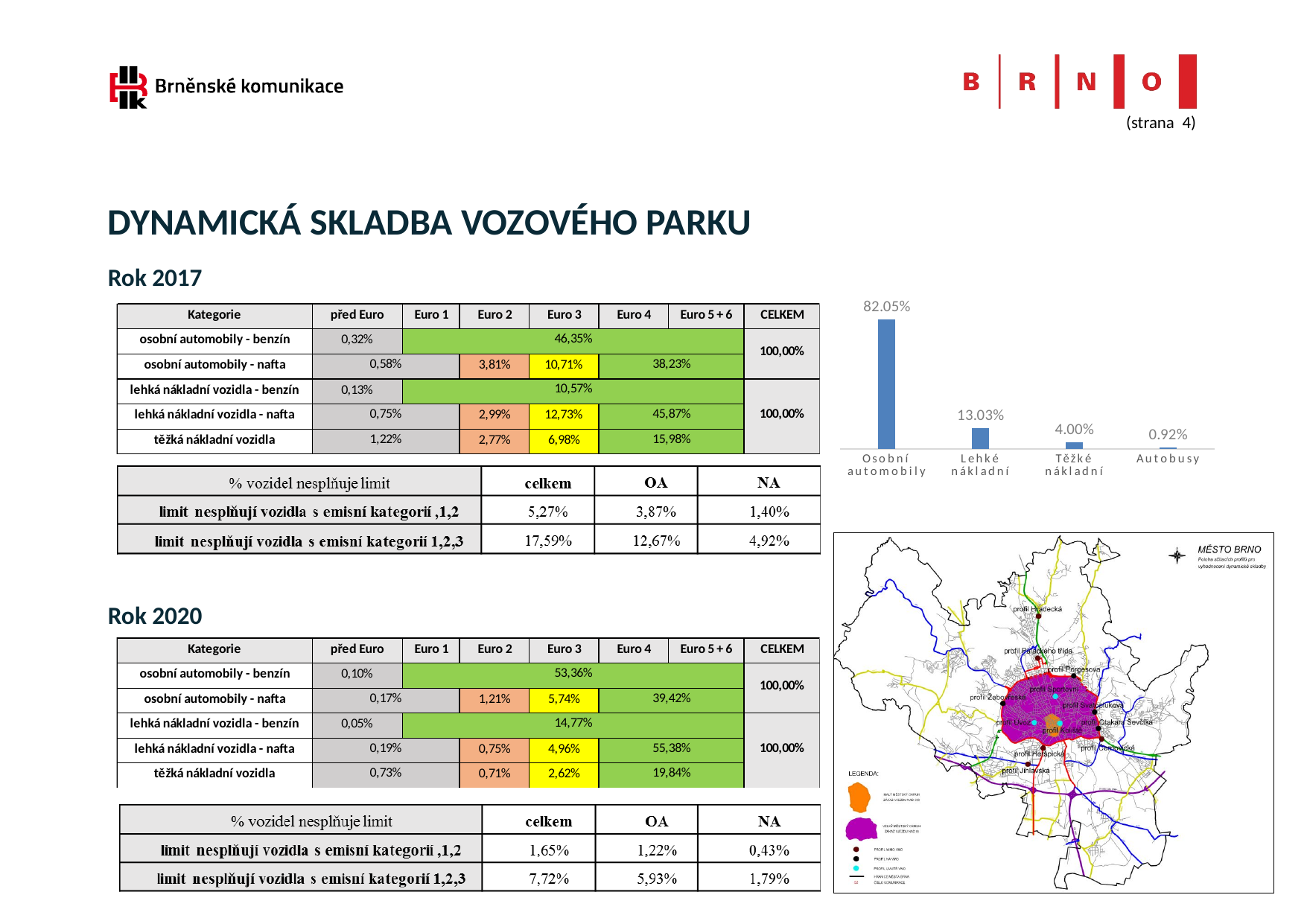
In the bar chart, which is larger: the value for Lehké nákladní or the value for Těžké nákladní? Lehké nákladní In the bar chart, what is the value for Osobní automobily? 82.05% In the bar chart, what is the difference between the values for Těžké nákladní and Autobusy? 3.08% Do the values in the bar chart rise or fall from left to right along the x axis? fall In the bar chart, what is the value for Lehké nákladní? 13.03% In the bar chart, which category has the highest value? Osobní automobily In the bar chart, what is the value for Těžké nákladní? 4.00% In the bar chart, what is the difference between the values for Osobní automobily and Lehké nákladní? 69.02% How many categories are shown in the bar chart? 4 In the bar chart, which category has the lowest value? Autobusy In the bar chart, what is the value for Autobusy? 0.92% What type of chart is shown on the right side of the slide? bar chart